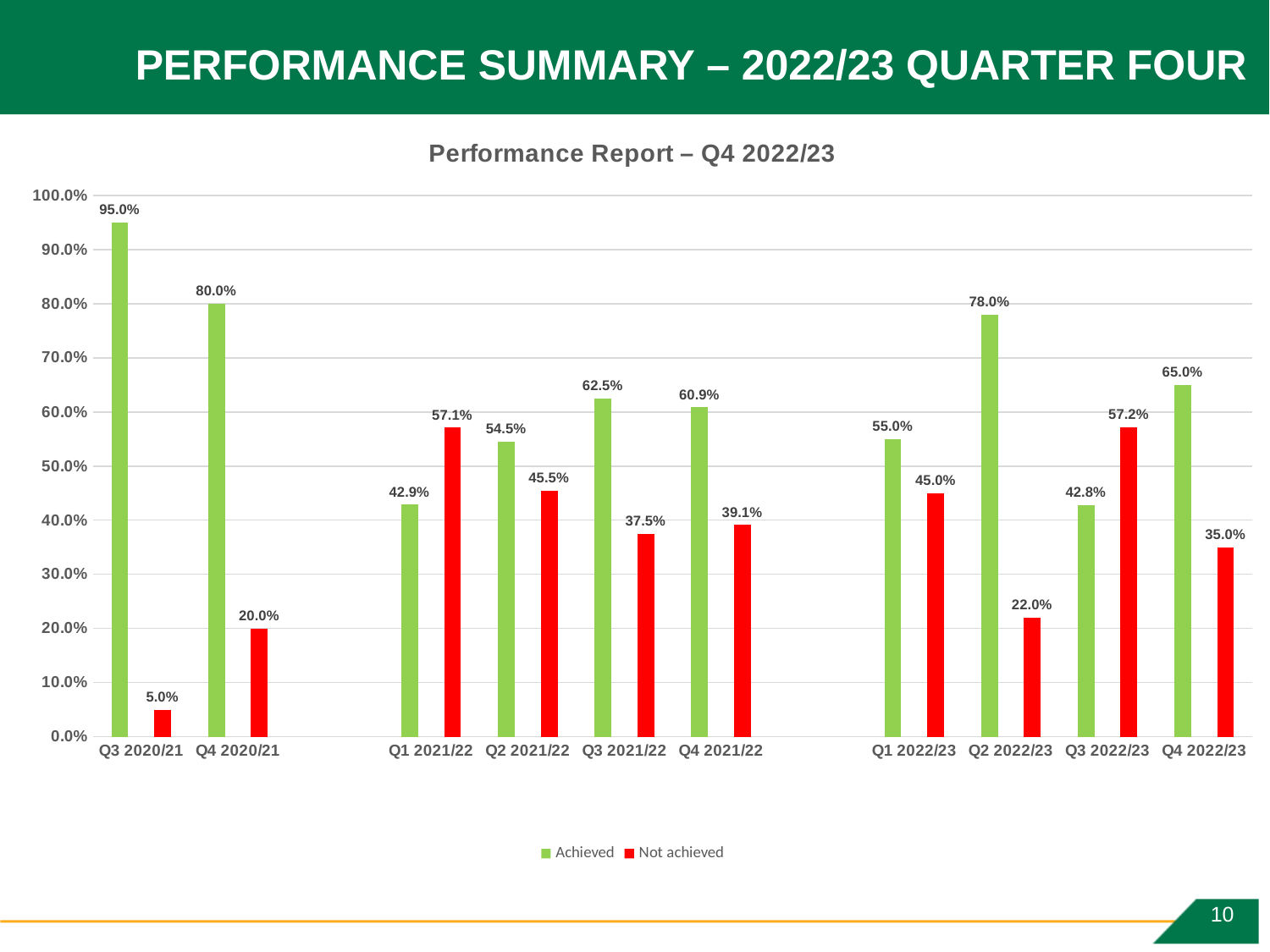
What is the Achieved value for Q4 2022/23? 65.0% What colour represents the Not achieved series? Red Do the Achieved values rise or fall from Q1 2022/23 to Q2 2022/23? Rise What kind of chart is shown on the slide? Bar chart What is the difference between the Achieved and Not achieved values for Q4 2022/23? 30.0% Which quarter has the highest Achieved value? Q3 2020/21 How many series does the legend list? 2 Which is larger for Q1 2021/22, the Achieved value or the Not achieved value? Not achieved What is the Achieved value for Q3 2020/21? 95.0% What is the Not achieved value for Q2 2022/23? 22.0% How many quarters are shown on the x axis? 10 Which quarter has the lowest Not achieved value? Q3 2020/21